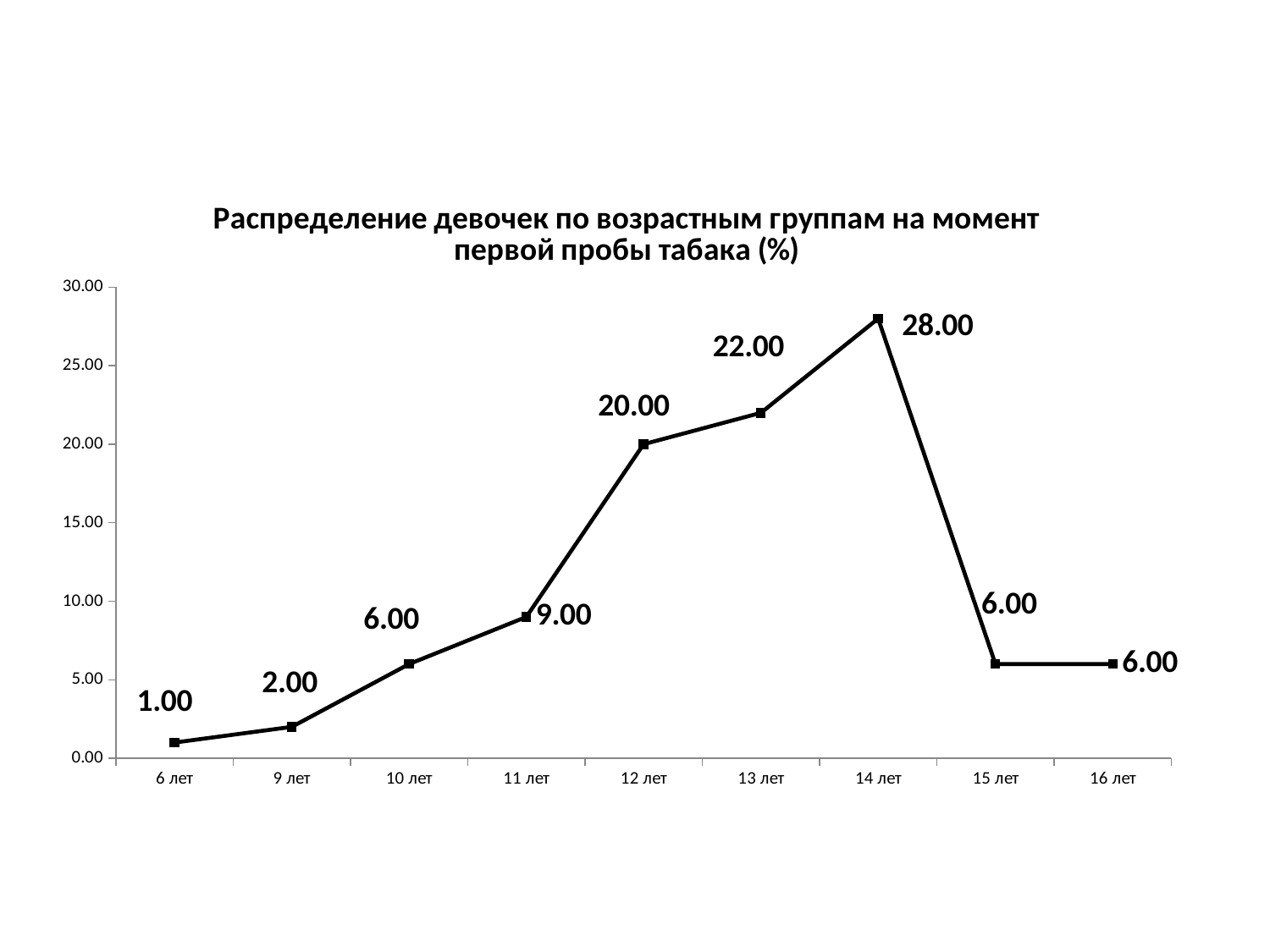
What is the difference between the values for 12 лет and 11 лет? 11.00 Do the values rise or fall from 6 лет to 14 лет? Rise What is the difference between the values for 14 лет and 13 лет? 6.00 What is the value for 14 лет? 28.00 Which is larger, the value for 13 лет or the value for 15 лет? 13 лет What is the value for 12 лет? 20.00 What kind of chart is this? Line chart How many age groups are plotted on the x axis? 9 What is the value for 6 лет? 1.00 What is the title of the chart? Распределение девочек по возрастным группам на момент первой пробы табака (%) Which age group has the highest value? 14 лет Which age group has the lowest value? 6 лет